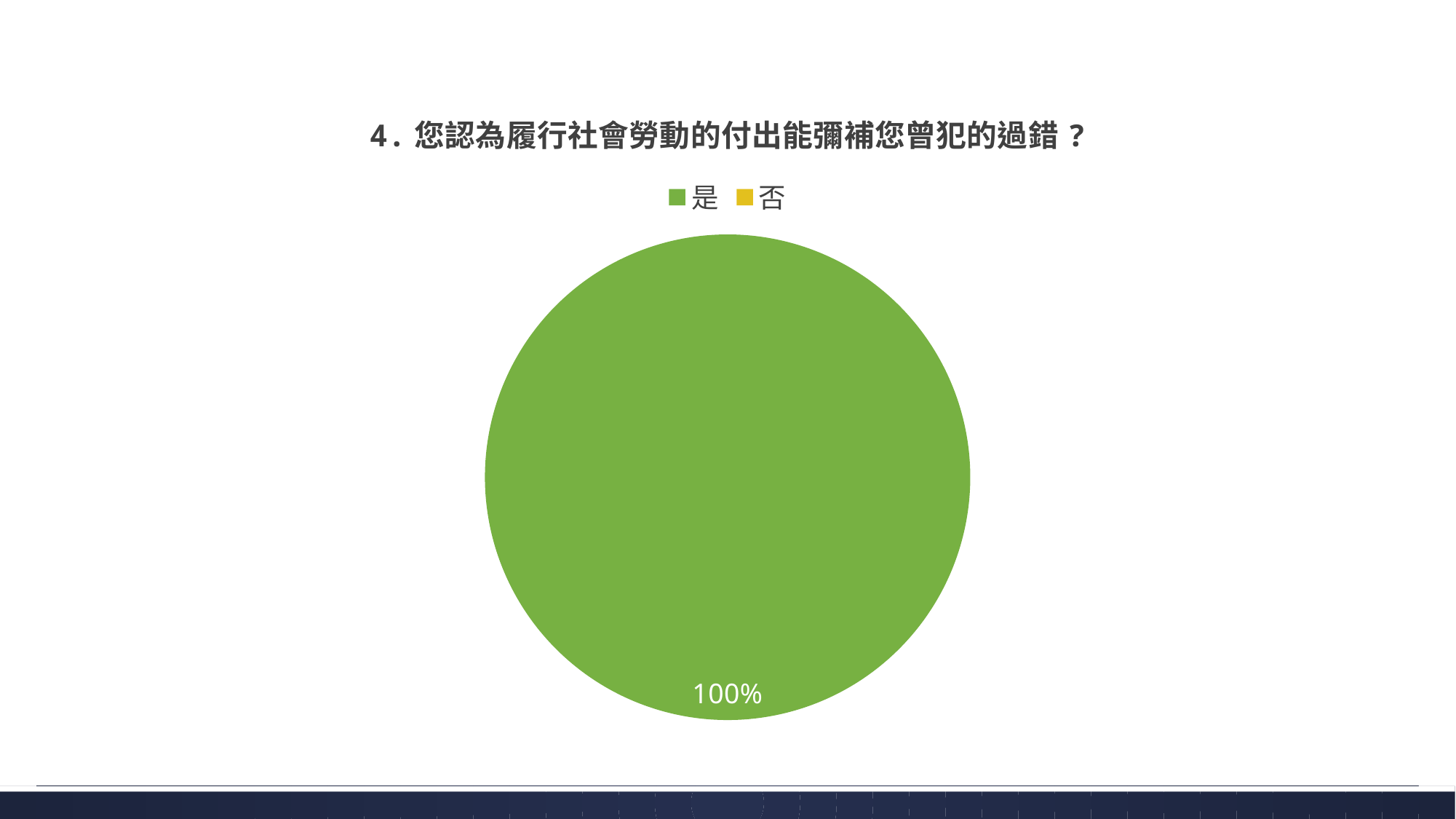
Which is larger, the share for 是 or the share for 否? 是 What kind of chart is shown on the slide? pie chart How many entries does the legend list? 2 What is the title of the chart? 4. 您認為履行社會勞動的付出能彌補您曾犯的過錯？ What colour represents 是 in the legend? green Is the share for 是 greater or less than 50%? greater Which category takes the largest share of the pie? 是 What is the data label printed on the pie chart? 100% What share of the pie does 是 take? 100%